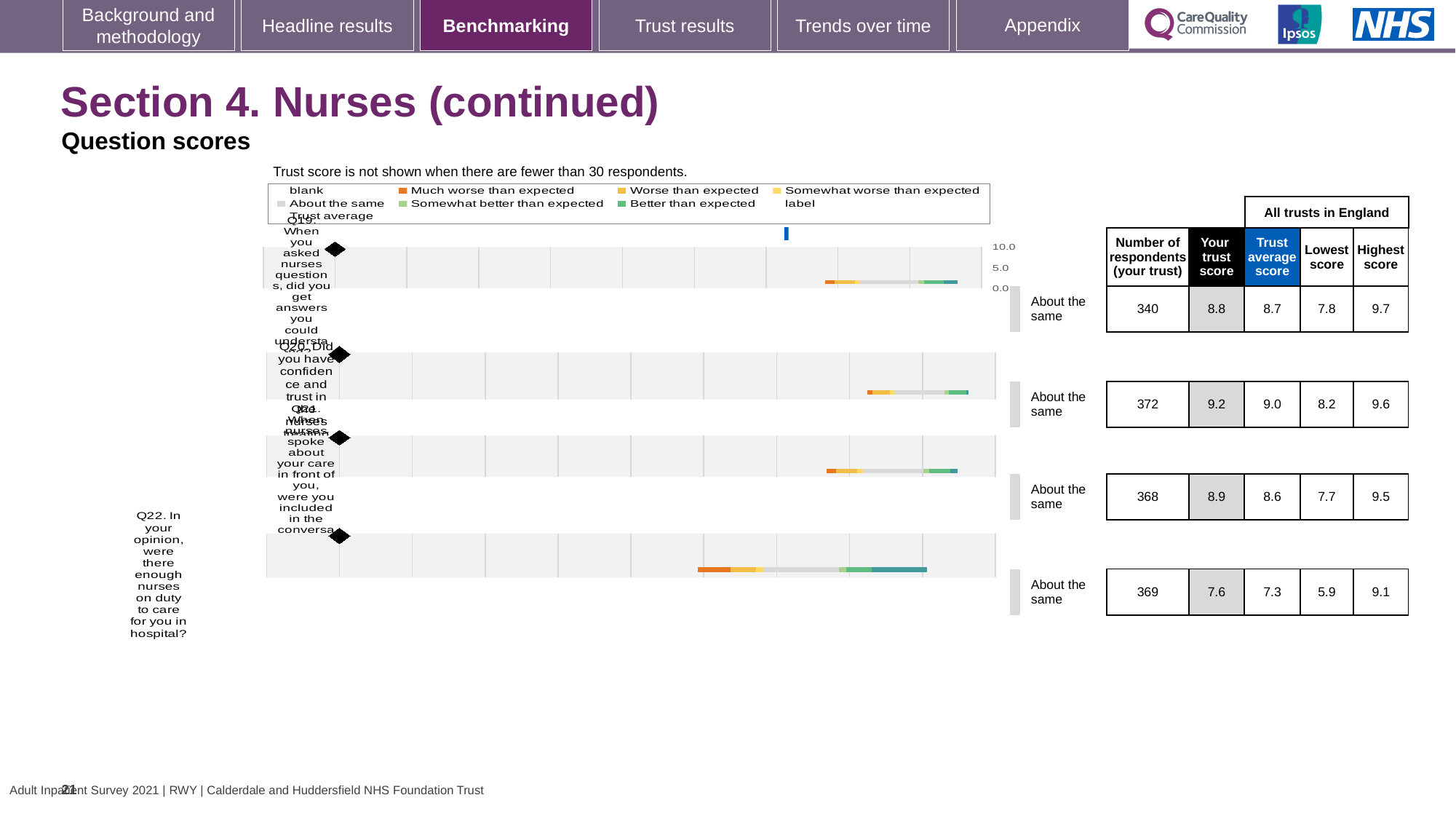
How many respondents from your trust answered Q20 (did you have confidence and trust in the nurses treating you)? 372 What is the difference between the highest and lowest scores in England for Q22? 3.2 Which question has the highest 'Your trust score'? Q20 What is the difference between your trust score and the trust average score for Q21? 0.3 How many questions are shown in the chart? 4 Which is larger: your trust score for Q19 or for Q21? Q21 Which question has the lowest 'Your trust score'? Q22 What is the highest score across all trusts in England for Q19? 9.7 What is the lowest score across all trusts in England for Q22? 5.9 What is the trust average score for Q22? 7.3 What benchmark category is shown for Q20? About the same What is the 'Your trust score' for Q22 (were there enough nurses on duty to care for you in hospital)? 7.6